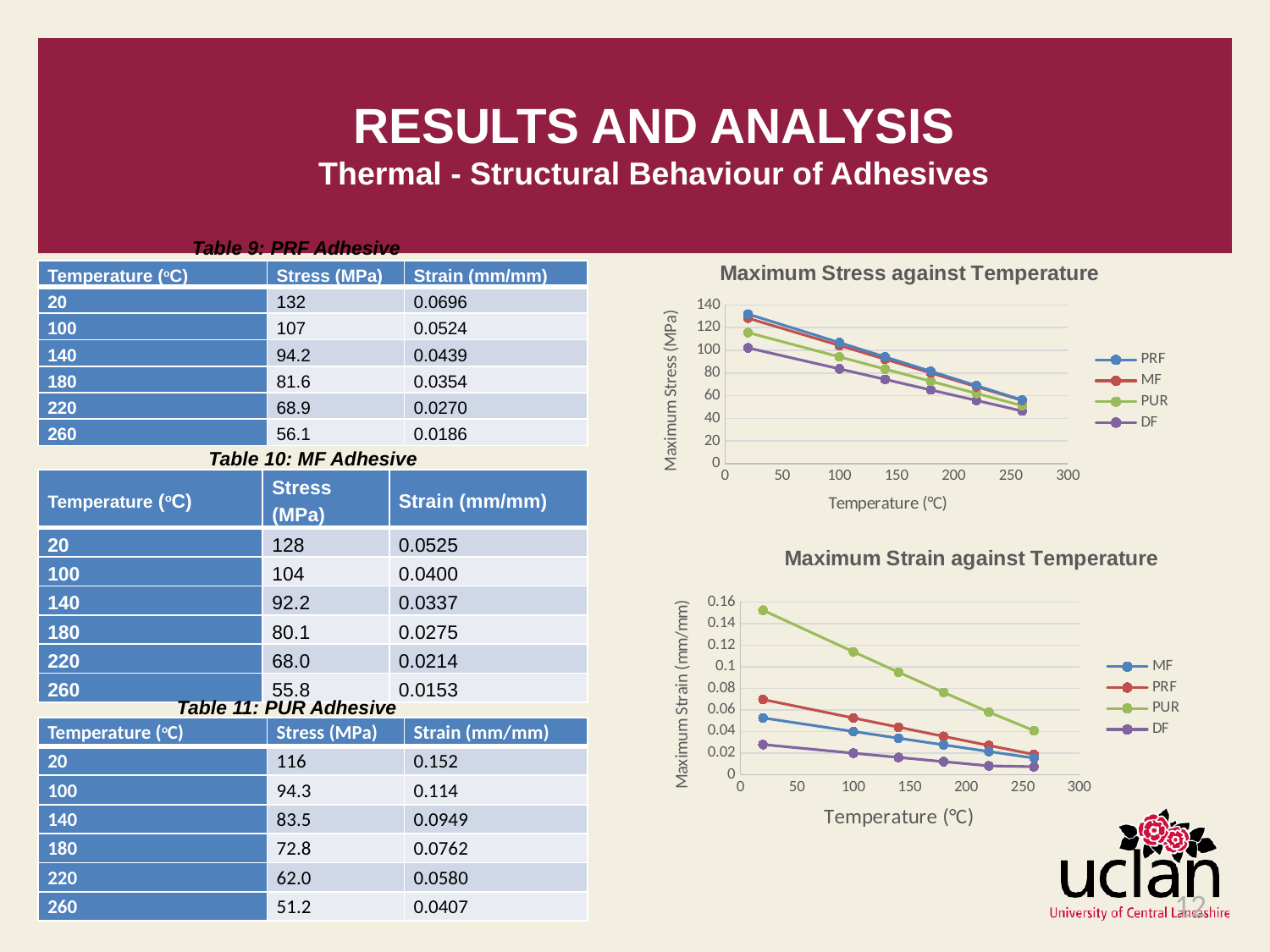
What kind of chart is the Maximum Stress against Temperature chart? line chart In the Maximum Strain against Temperature chart, which is larger at 140°C, the PUR value or the MF value? PUR In the Maximum Stress against Temperature chart, is the DF value at 260°C greater or less than 60? less In the Maximum Stress against Temperature chart, is the PRF value at 20°C greater or less than 120? greater In the Maximum Strain against Temperature chart, which series has the highest strain at 20°C? PUR What is the x-axis title of the Maximum Strain against Temperature chart? Temperature (°C) In the Maximum Stress against Temperature chart, how many data points are plotted for each series? 6 In the Maximum Stress against Temperature chart, which series has the lowest stress at 20°C? DF In the Maximum Stress against Temperature chart, how many series does the legend list? 4 In the Maximum Strain against Temperature chart, which series has the lowest strain at 260°C? DF In the Maximum Stress against Temperature chart, do the values rise or fall as temperature increases? fall In the Maximum Strain against Temperature chart, is the PUR value at 100°C greater or less than 0.1? greater